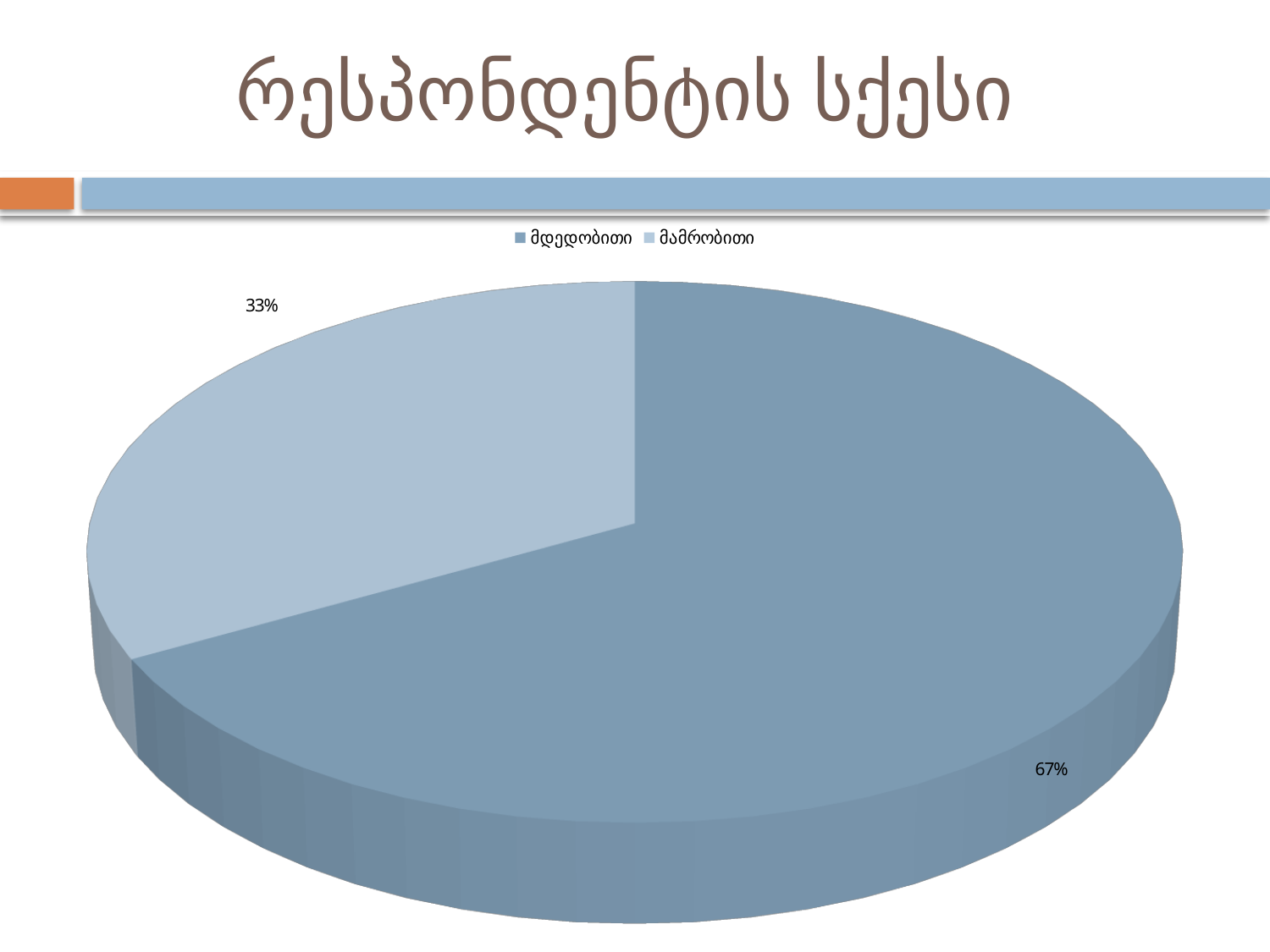
Which legend entry is shown in the lighter blue colour? მამრობითი Which category has the largest slice of the pie? მდედობითი What kind of chart is shown on the slide? Pie chart What share of the pie does მდედრობითი represent? 67% What share of the pie does მამრობითი represent? 33% Which category has the smallest slice of the pie? მამრობითი How many entries does the legend list? 2 What is the difference in percentage points between the მდედრობითი slice and the მამრობითი slice? 34% How many slices does the pie chart have? 2 Which is larger, the slice for მდედრობითი or the slice for მამრობითი? მდედობითი What is the title of the slide? რესპონდენტის სქესი